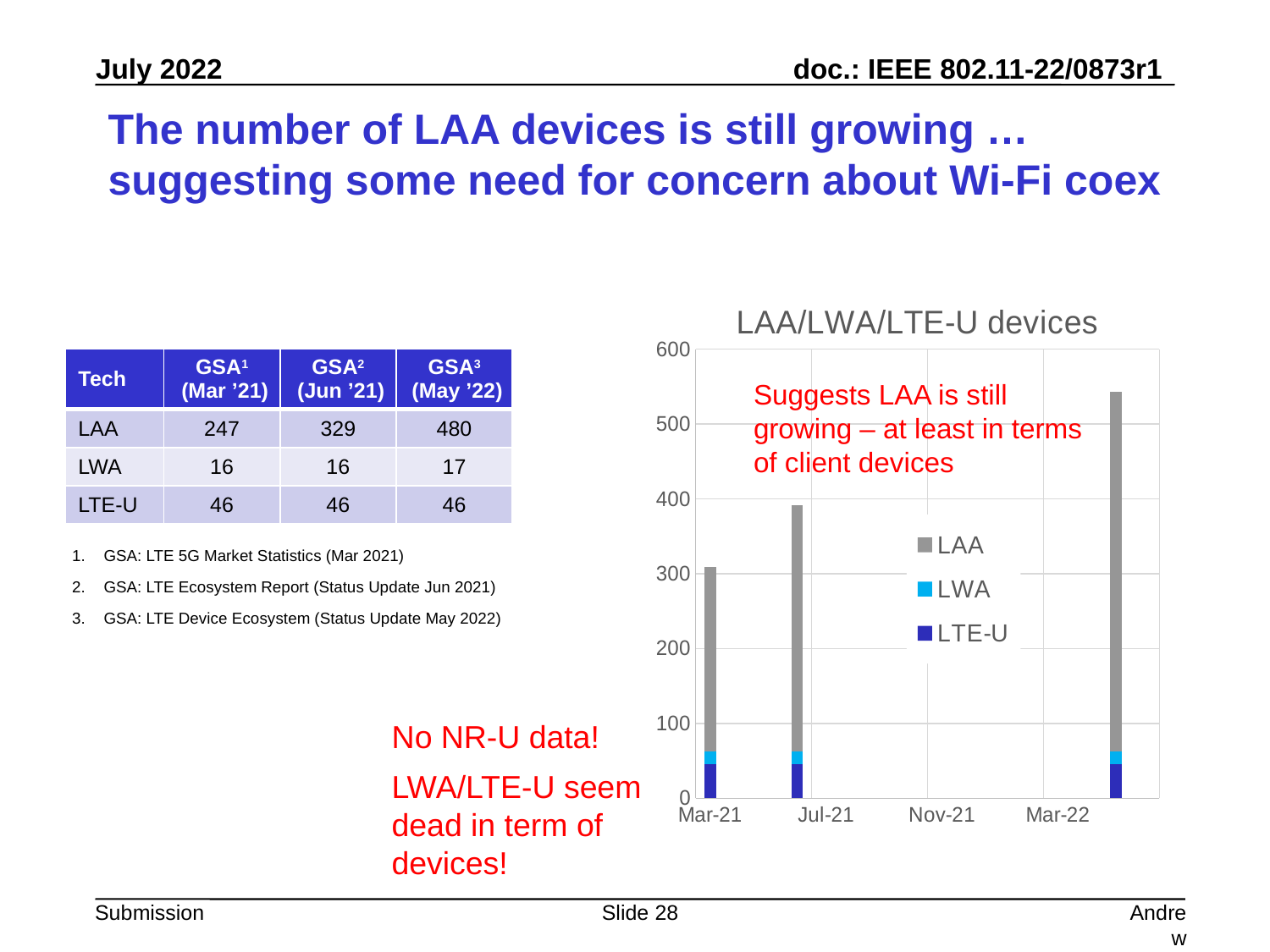
Which series makes up the largest portion of each stacked bar? LAA What kind of chart is shown on the slide? bar chart Which series is shown in gray in the chart legend? LAA Which bar has the greatest total height: the leftmost, the middle, or the rightmost? the rightmost How many series does the chart legend list? 3 Is the total height of the leftmost bar (at Mar-21) greater or less than 400? less Is the total height of the middle bar greater or less than 300? greater How many stacked bars are plotted in the chart? 3 Do the total bar heights rise or fall from left to right along the x axis? rise Is the total height of the rightmost bar greater or less than 500? greater What is the title of the chart? LAA/LWA/LTE-U devices